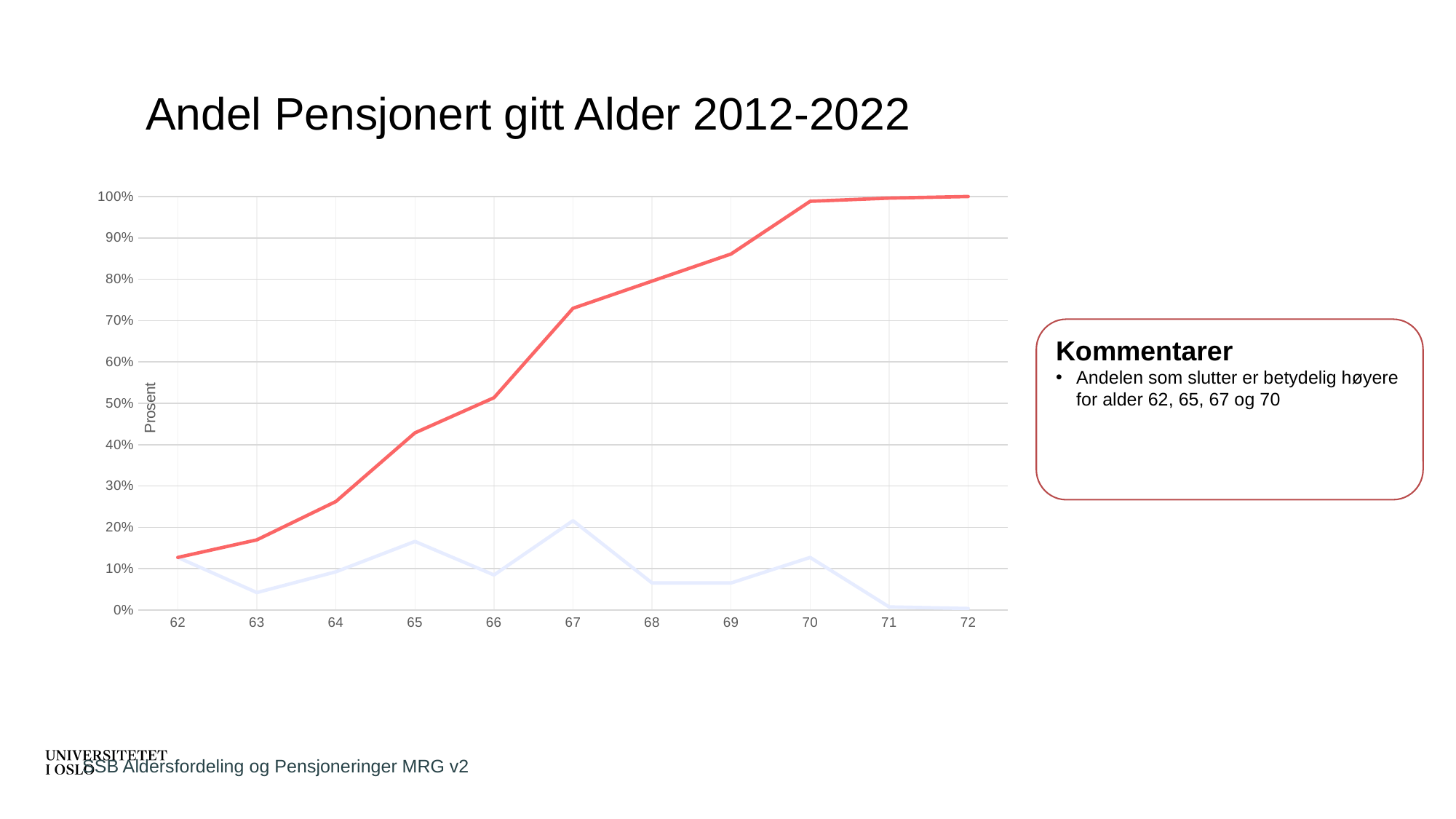
How many age categories are shown on the x axis? 11 What is the title of the chart? Andel Pensjonert gitt Alder 2012-2022 What kind of chart is shown on the slide? line chart What is the label on the y axis of the chart? Prosent Is the value of the red line at age 69 greater or less than 80%? greater Which is larger on the red line: the value at age 65 or the value at age 67? 67 Is the value of the red line at age 67 greater or less than 70%? greater Does the red line rise or fall as age increases from 62 to 72? rises Is the value of the red line at age 70 greater or less than 90%? greater At which age does the light blue line reach its highest value? 67